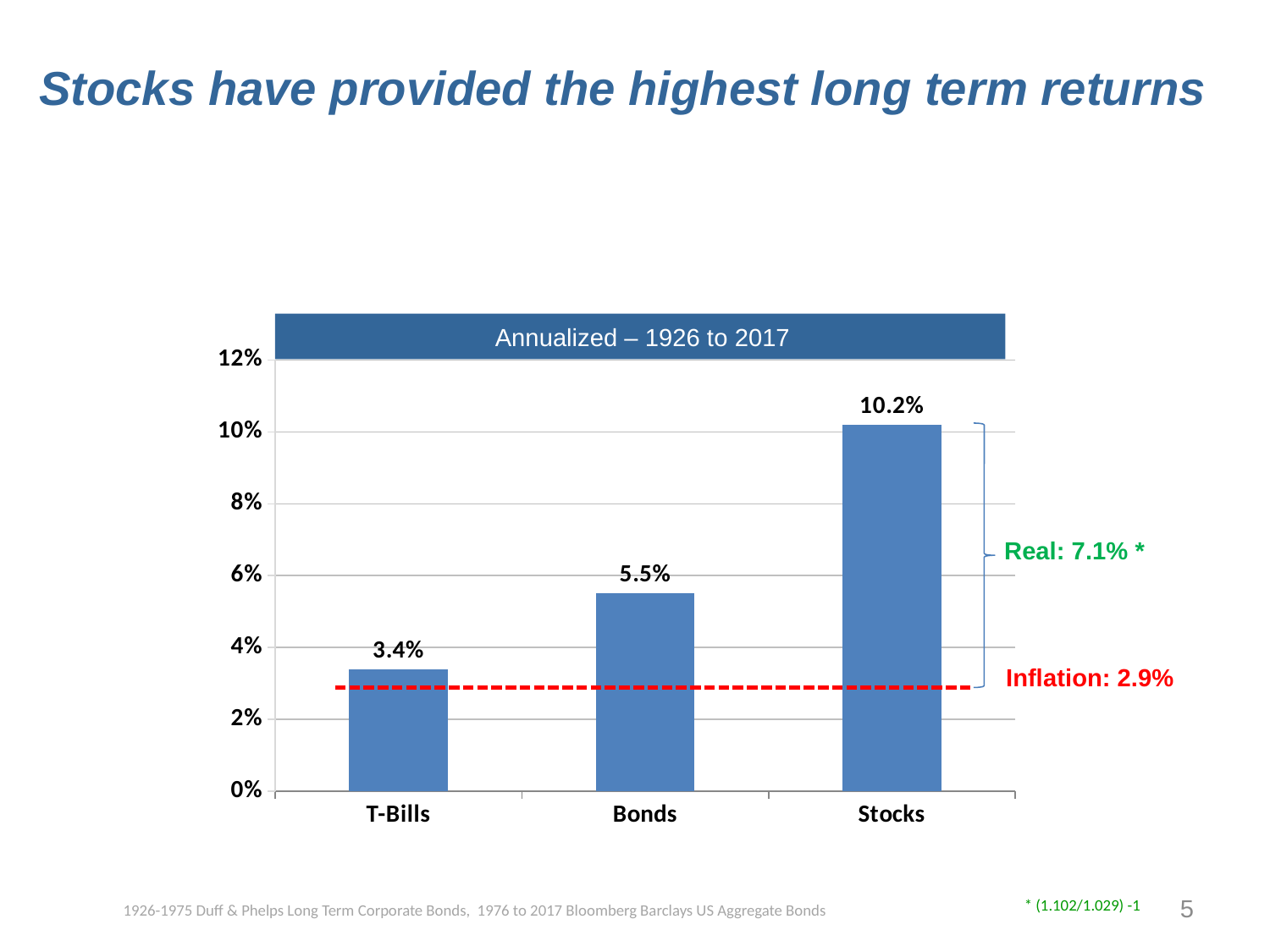
Which category has the highest annualized return? Stocks Which has a higher annualized return, Bonds or T-Bills? Bonds What is the difference between the annualized returns of Bonds and T-Bills? 2.1% What kind of chart is shown on the slide? Bar chart What is the difference between the annualized returns of Stocks and Bonds? 4.7% What is the annualized return for Bonds? 5.5% What is the annualized return for T-Bills? 3.4% Which category has the lowest annualized return? T-Bills What inflation rate is indicated by the red dashed line? 2.9% How many categories are shown in the chart? 3 What is the annualized return for Stocks? 10.2% Is the value for Stocks greater or less than 8%? greater